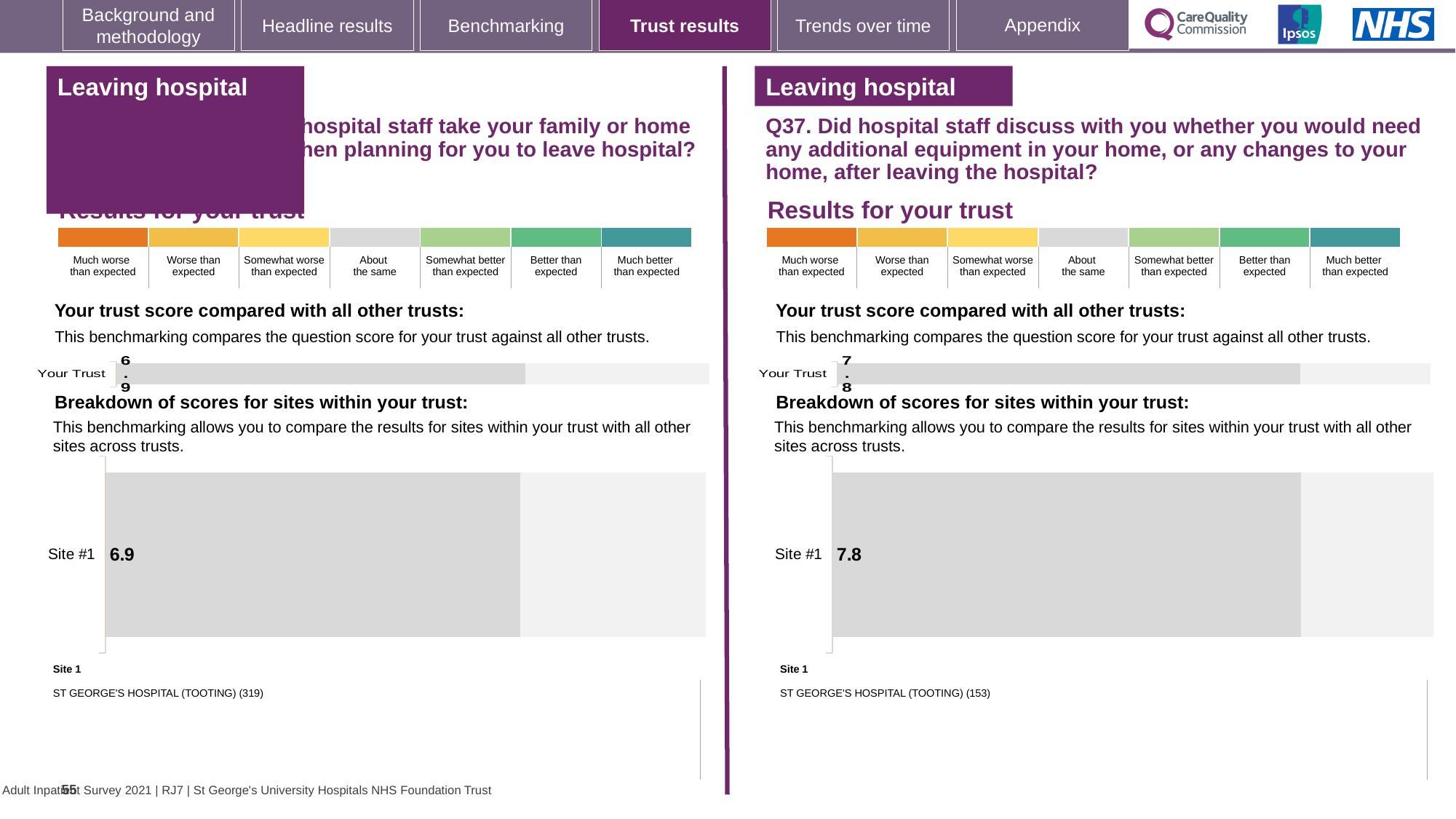
What is the difference between the Site #1 score on the right half of the slide (Q37) and the Site #1 score on the left half? 0.9 How many sites are shown in the 'Breakdown of scores for sites within your trust' chart on the left half of the slide? 1 On the left half of the slide, what is the value shown for Site #1 in the 'Breakdown of scores for sites within your trust' chart? 6.9 How many sites are shown in the 'Breakdown of scores for sites within your trust' chart on the right half of the slide? 1 On the left half of the slide, what score is shown for 'Your Trust' in the 'Your trust score compared with all other trusts' chart? 6.9 On the right half of the slide, which site is listed as Site 1 below the chart? ST GEORGE'S HOSPITAL (TOOTING) (153) On the right half of the slide (Q37), what is the value shown for Site #1 in the 'Breakdown of scores for sites within your trust' chart? 7.8 On the right half of the slide (Q37), what score is shown for 'Your Trust' in the 'Your trust score compared with all other trusts' chart? 7.8 On the left half of the slide, which site is listed as Site 1 below the chart? ST GEORGE'S HOSPITAL (TOOTING) (319) What kind of chart is used to show the Site #1 score on the right half of the slide? Bar chart Which is larger: the Site #1 score on the left half of the slide or the Site #1 score on the right half (Q37)? Right half (Q37)